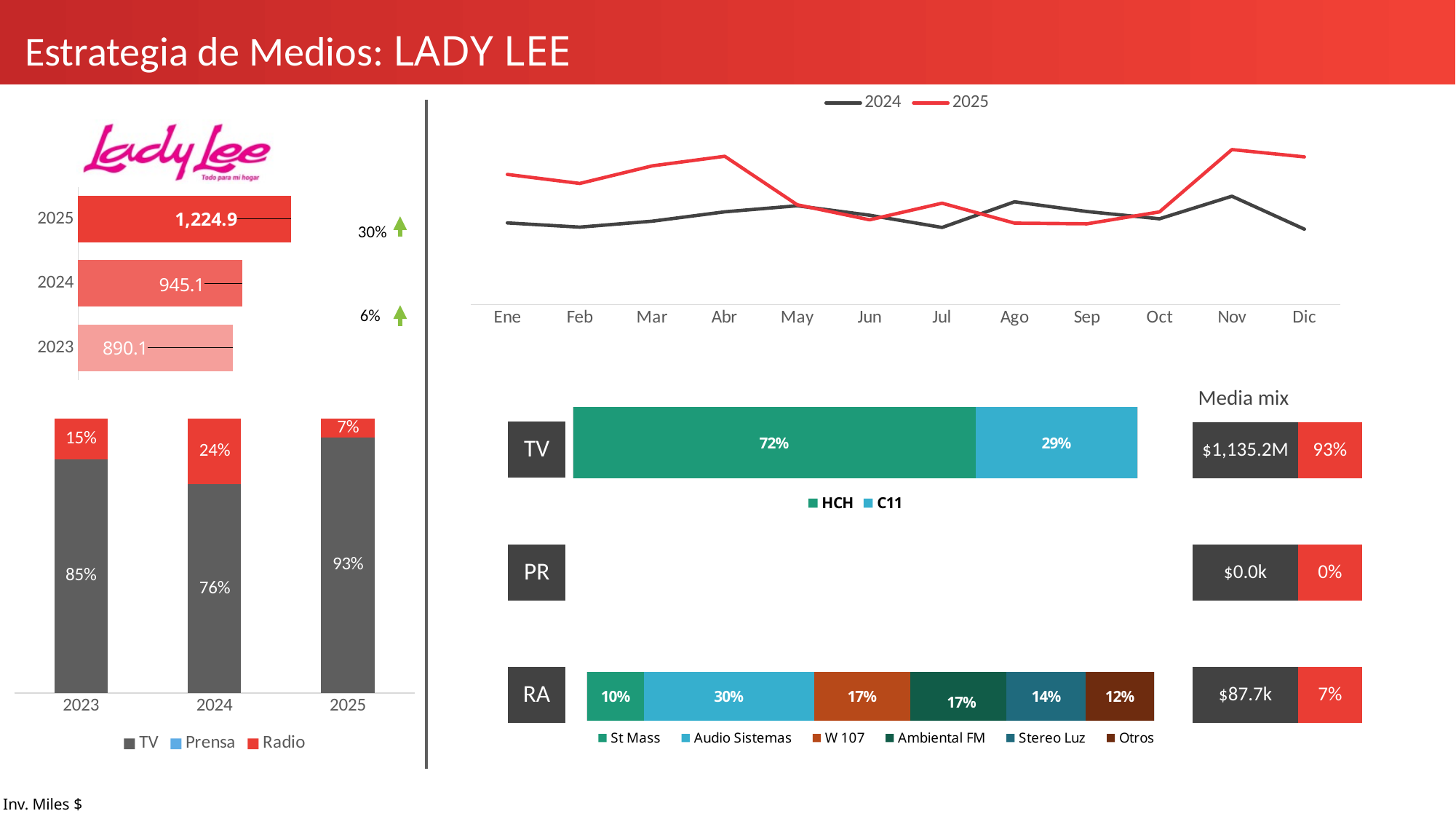
In the monthly line chart at the top right, which line is higher in Abr, 2024 or 2025? 2025 In the RA stacked bar at the bottom right, which station has the largest share? Audio Sistemas In the TV stacked bar in the middle right, what is the share for HCH? 72% How many series does the legend of the stacked bar chart at the bottom left list? 3 In the stacked bar chart at the bottom left, what is the Radio share for 2025? 7% In the yearly investment bar chart on the left, which year has the lowest value? 2023 In the Media mix panel, what is the investment value shown for RA? $87.7k In the stacked bar chart at the bottom left, what is the TV share for 2024? 76% In the monthly line chart at the top right, how many months are shown on the x axis? 12 In the yearly investment bar chart on the left, what is the value for 2025? 1,224.9 In the yearly investment bar chart on the left, what is the value for 2023? 890.1 In the yearly investment bar chart on the left, what is the difference between the 2025 and 2024 values? 279.8